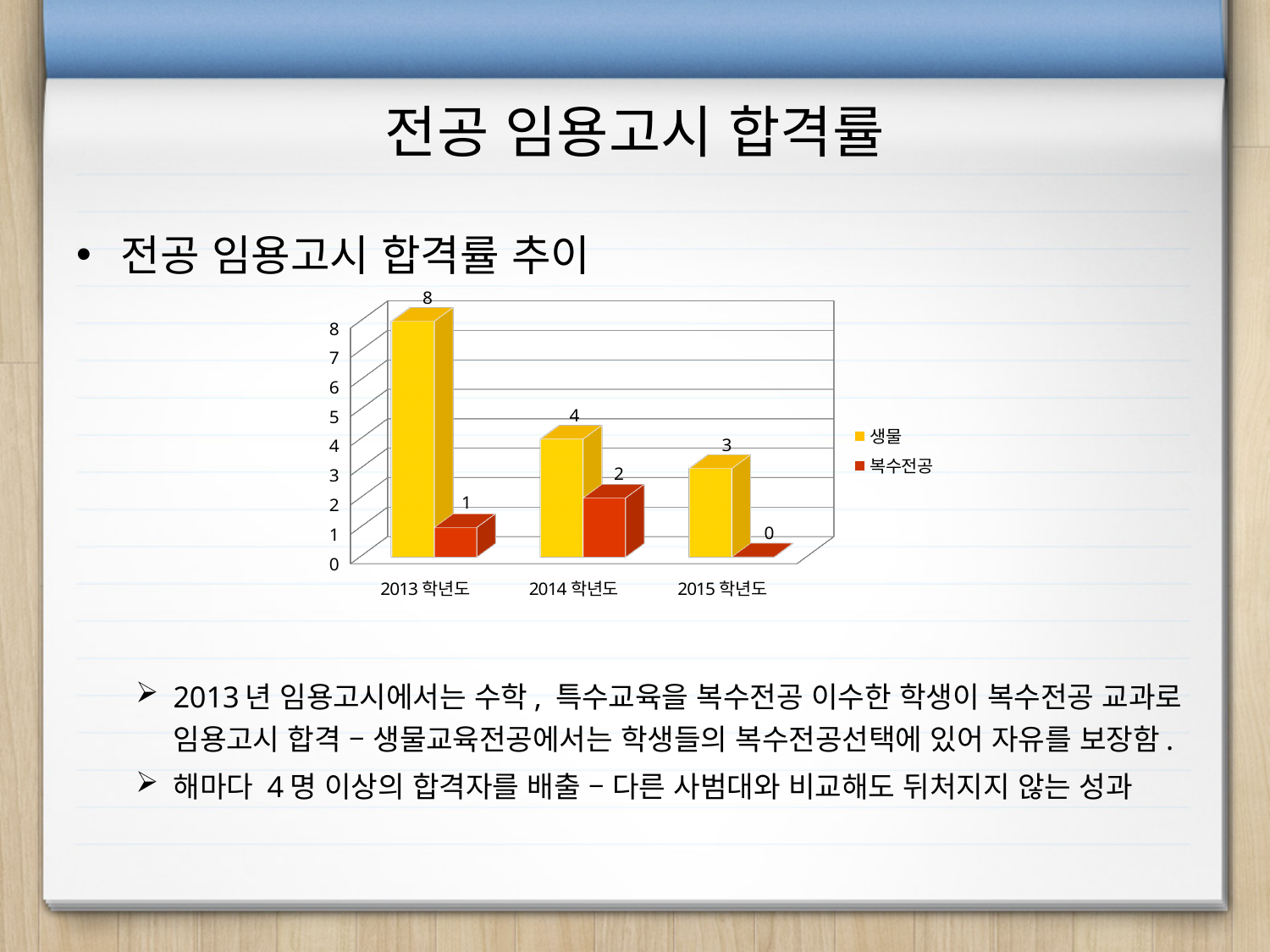
Which year has the lowest value for 복수전공? 2015 학년도 What is the value for 복수전공 in 2014 학년도? 2 Do the 생물 values rise or fall from 2013 학년도 to 2015 학년도? fall What kind of chart is shown on the slide? bar chart What is the value for 생물 in 2015 학년도? 3 Which is larger in 2014 학년도, 생물 or 복수전공? 생물 Which year has the highest value for 생물? 2013 학년도 How many year categories are shown on the x axis? 3 What is the value for 생물 in 2013 학년도? 8 How many series does the legend list? 2 What is the value for 복수전공 in 2015 학년도? 0 What is the difference between the 생물 and 복수전공 values in 2013 학년도? 7